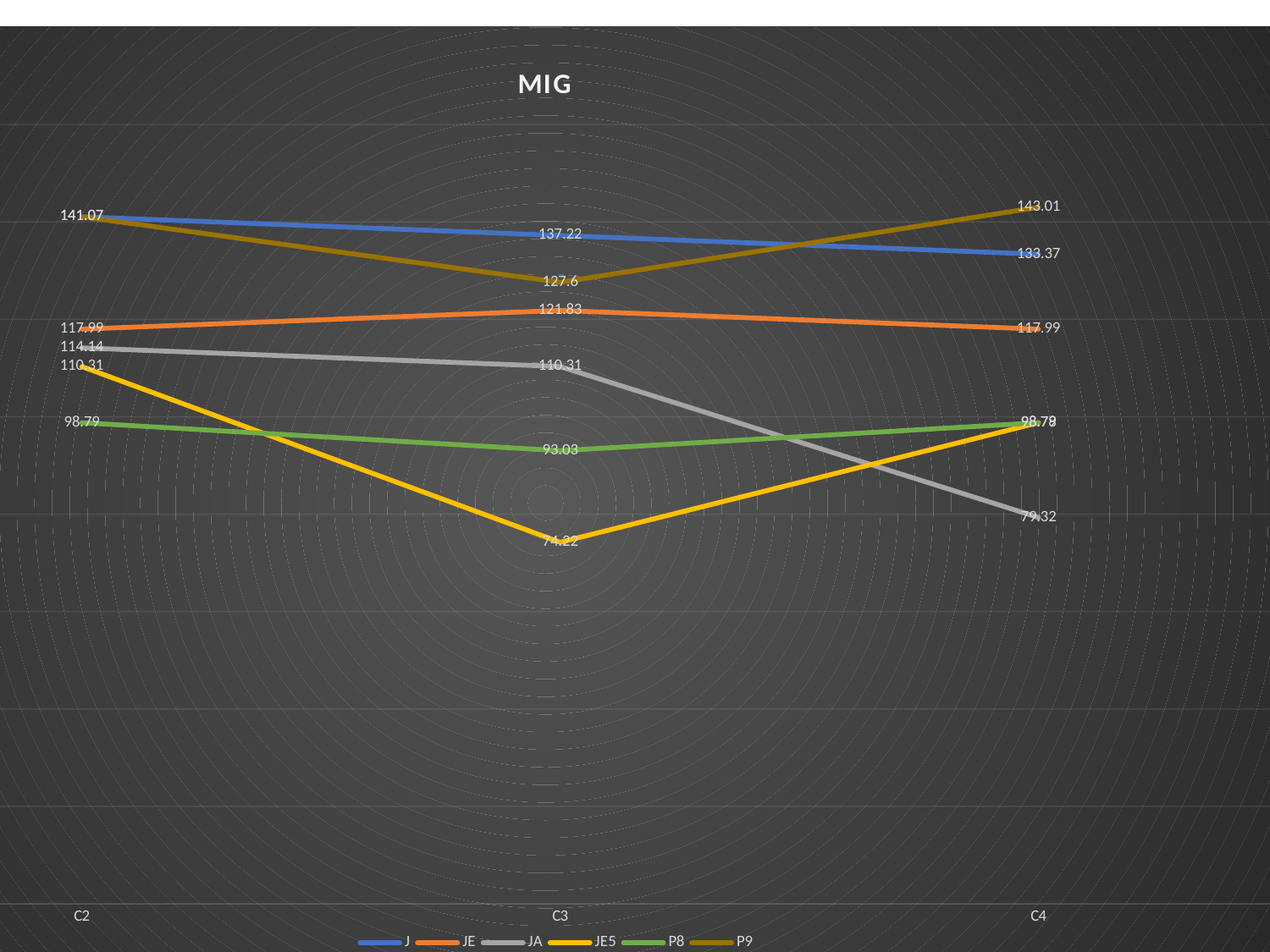
How many categories are shown on the x axis? 3 What kind of chart is shown on the slide? line chart What is the value of series J at C3? 137.22 How many series does the legend list? 6 What is the value of series JA at C4? 79.32 What is the value of series P9 at C4? 143.01 At C3, which is larger: the value of JE or the value of P9? P9 What is the value of series JE5 at C3? 74.22 Which series has the highest value at C4? P9 Does series J rise or fall from C2 to C4? fall Which series has the lowest value at C3? JE5 By how much does series J fall from C2 to C4? 7.7